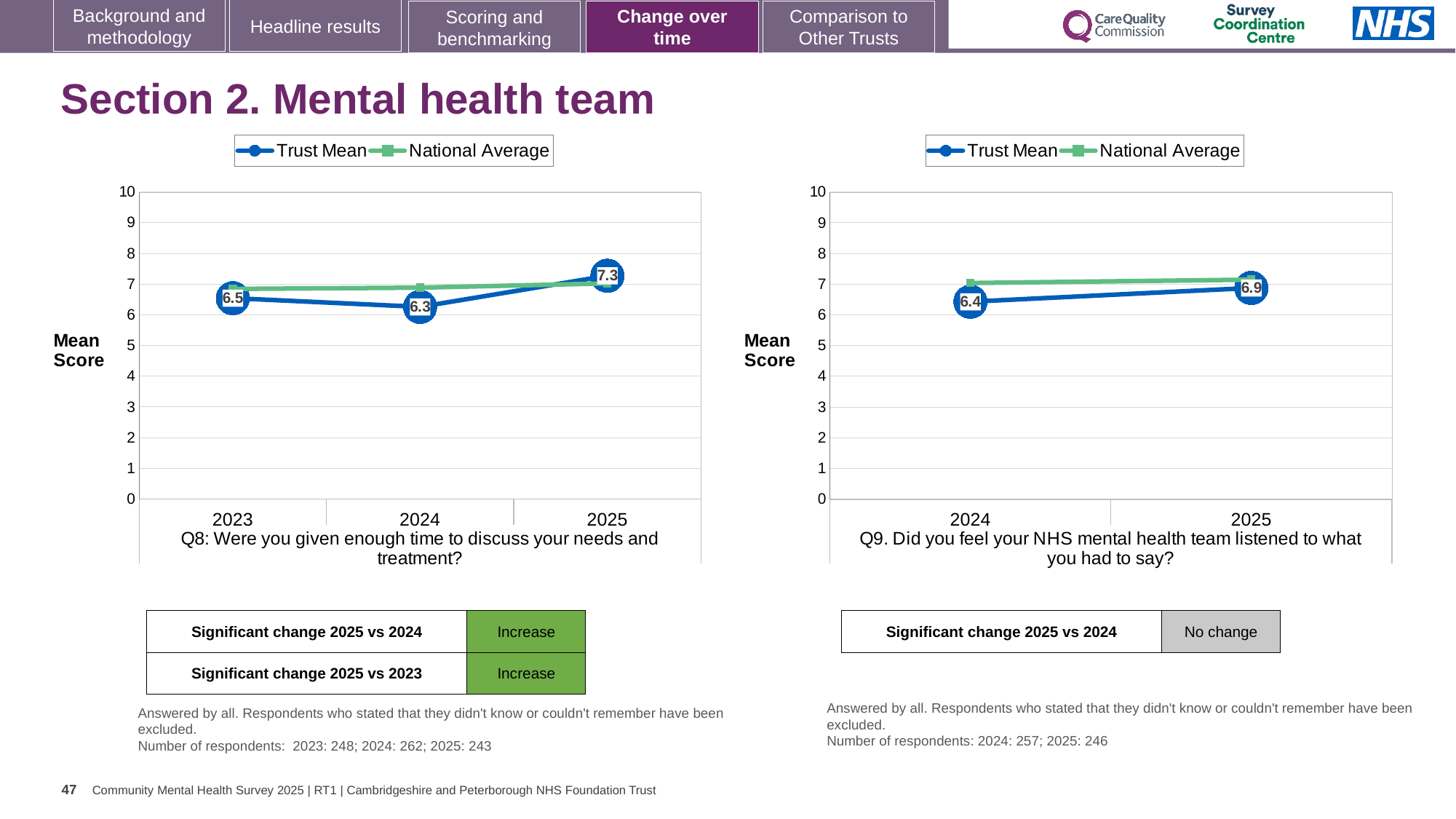
What kind of chart is the Q8 chart on the left? Line chart In the Q8 chart on the left, which year has the lowest Trust Mean? 2024 In the Q8 chart on the left, what is the Trust Mean for 2024? 6.3 In the Q8 chart on the left, what is the difference between the Trust Mean for 2025 and 2024? 1.0 How many series does the legend of the Q8 chart on the left list? 2 In the Q9 chart on the right, is the Trust Mean for 2024 greater or less than 7? less In the Q8 chart on the left, what is the Trust Mean for 2025? 7.3 In the Q9 chart on the right, what is the difference between the Trust Mean for 2025 and 2024? 0.5 How many years are plotted on the x axis of the Q9 chart on the right? 2 In the Q8 chart on the left, which year has the highest Trust Mean? 2025 In the Q9 chart on the right, what is the Trust Mean for 2024? 6.4 In the Q9 chart on the right, what is the Trust Mean for 2025? 6.9